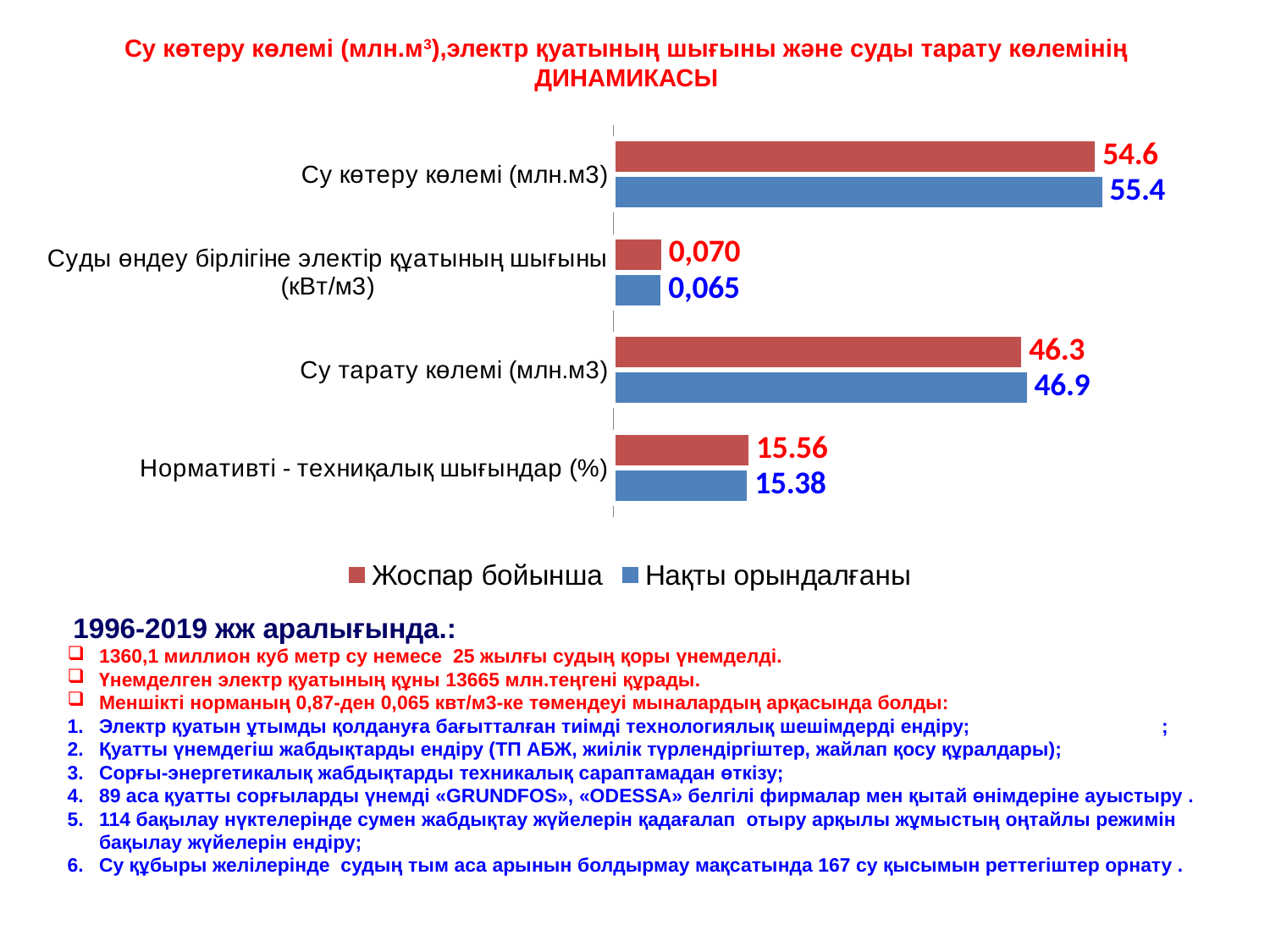
What type of chart is shown on the slide? Bar chart What is the value of the "Нақты орындалғаны" series for "Су көтеру көлемі (млн.м3)"? 55.4 What is the "Нақты орындалғаны" value for "Нормативті - техниқалық шығындар (%)"? 15.38 Which category has the highest "Жоспар бойынша" value? Су көтеру көлемі (млн.м3) What is the difference between the "Нақты орындалғаны" and "Жоспар бойынша" values for "Су көтеру көлемі (млн.м3)"? 0.8 How many categories are shown in the chart? 4 What is the "Жоспар бойынша" value for "Суды өндеу бірлігіне электір құатының шығыны (кВт/м3)"? 0,070 Which category has the lowest "Нақты орындалғаны" value? Суды өндеу бірлігіне электір құатының шығыны (кВт/м3) For "Нормативті - техниқалық шығындар (%)", which is larger: the "Жоспар бойынша" value or the "Нақты орындалғаны" value? Жоспар бойынша What is the "Нақты орындалғаны" value for "Су тарату көлемі (млн.м3)"? 46.9 How many series does the legend list? 2 What is the value of the "Жоспар бойынша" series for "Су көтеру көлемі (млн.м3)"? 54.6